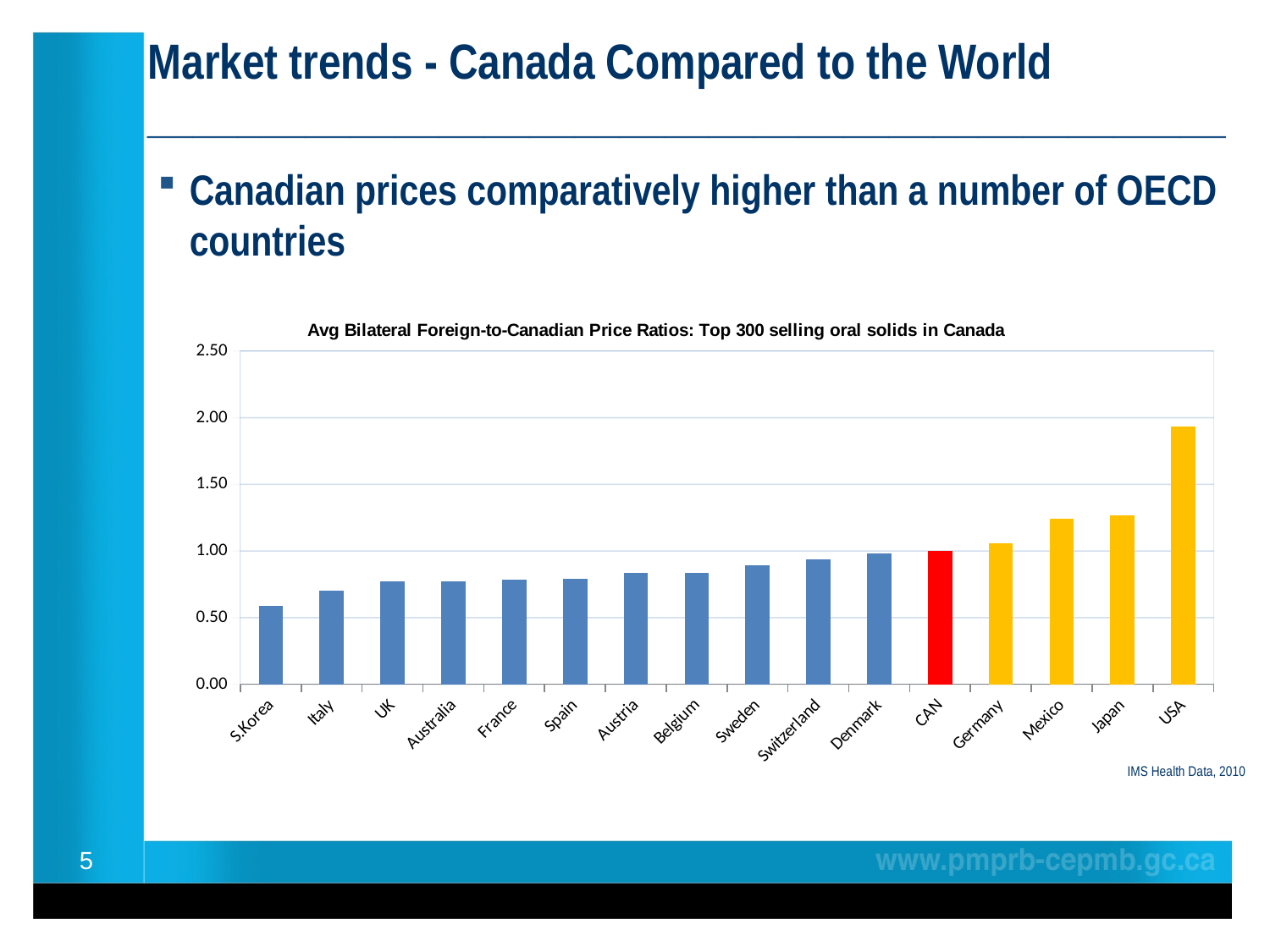
How many countries are shown on the x axis of the chart? 16 Is the value for S.Korea greater or less than 1.00? less What colour is the bar for CAN? Red What is the title of the chart? Avg Bilateral Foreign-to-Canadian Price Ratios: Top 300 selling oral solids in Canada What is the price ratio for CAN? 1.00 What kind of chart is shown on the slide? Bar chart Is the value for Mexico greater or less than 1.00? greater Which country has the highest price ratio in the chart? USA Which country has the lowest price ratio in the chart? S.Korea Do the values generally rise or fall moving from left to right along the x axis? Rise Which has the larger price ratio, USA or Italy? USA Is the value for USA greater or less than 1.50? greater